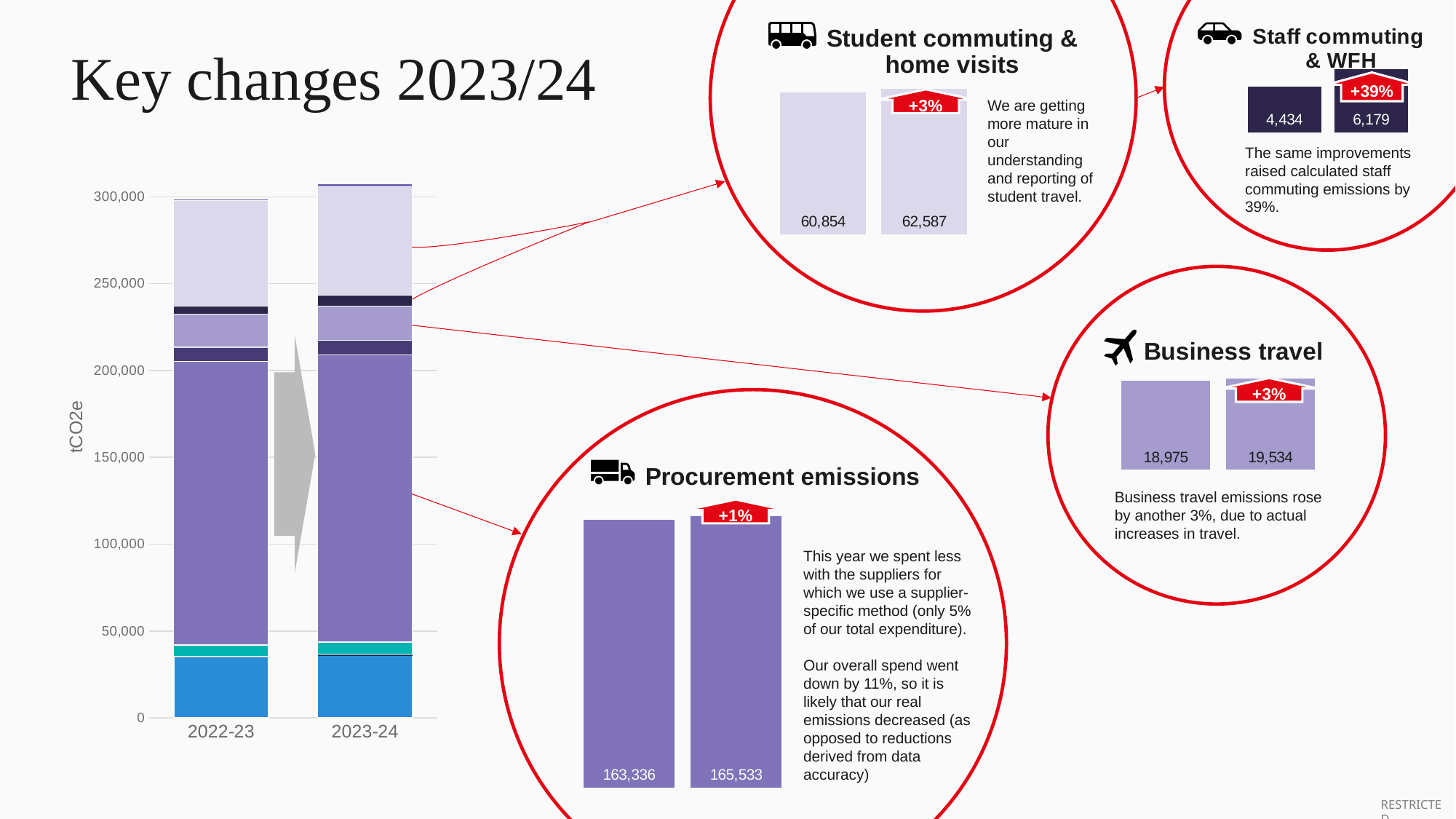
In the Business travel chart, what value is shown on the right-hand bar? 19,534 In the Student commuting & home visits chart, what value is shown on the right-hand bar? 62,587 In the Student commuting & home visits chart, what value is shown on the left-hand bar? 60,854 How many categories are shown on the x axis of the large chart on the left? 2 On the large chart on the left, is the total height of the 2023-24 bar greater or less than 250,000? greater What kind of chart is the large chart on the left of the slide? Stacked bar chart In the Staff commuting & WFH chart, what is the difference between the right-hand bar (6,179) and the left-hand bar (4,434)? 1,745 Which is larger: the right-hand bar in the Procurement emissions chart or the right-hand bar in the Student commuting & home visits chart? Procurement emissions (165,533) In the Procurement emissions chart, what is the difference between the right-hand bar (165,533) and the left-hand bar (163,336)? 2,197 In the Business travel chart, what is the difference between the right-hand bar (19,534) and the left-hand bar (18,975)? 559 What is the y-axis label of the large chart on the left? tCO2e In the Staff commuting & WFH chart, what percentage change is shown above the right-hand bar? +39%